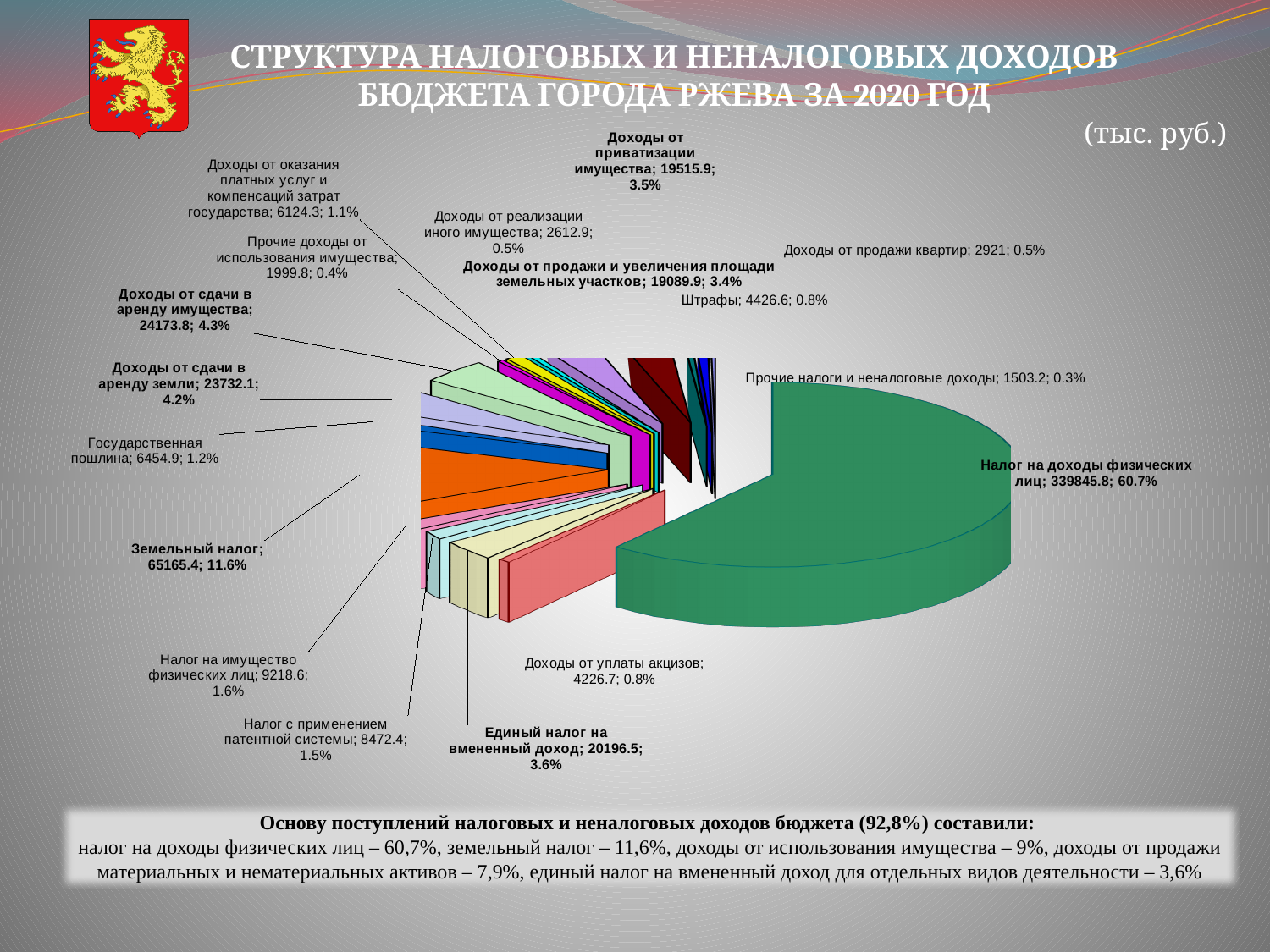
What value is shown for Единый налог на вмененный доход? 20196.5 What unit is indicated for the values on the chart? тыс. руб. What is the difference between the values for Земельный налог and Единый налог на вмененный доход? 44968.9 What kind of chart is shown on the slide? pie chart Which category has the smallest slice of the pie? Прочие налоги и неналоговые доходы What value is shown for Штрафы? 4426.6 What share of the pie does Доходы от приватизации имущества represent? 3.5% What share of the pie does Земельный налог represent? 11.6% How many categories are labelled on the pie chart? 17 Which is larger: Доходы от сдачи в аренду имущества or Доходы от сдачи в аренду земли? Доходы от сдачи в аренду имущества Which category has the largest slice of the pie? Налог на доходы физических лиц What value is shown for Налог на доходы физических лиц? 339845.8